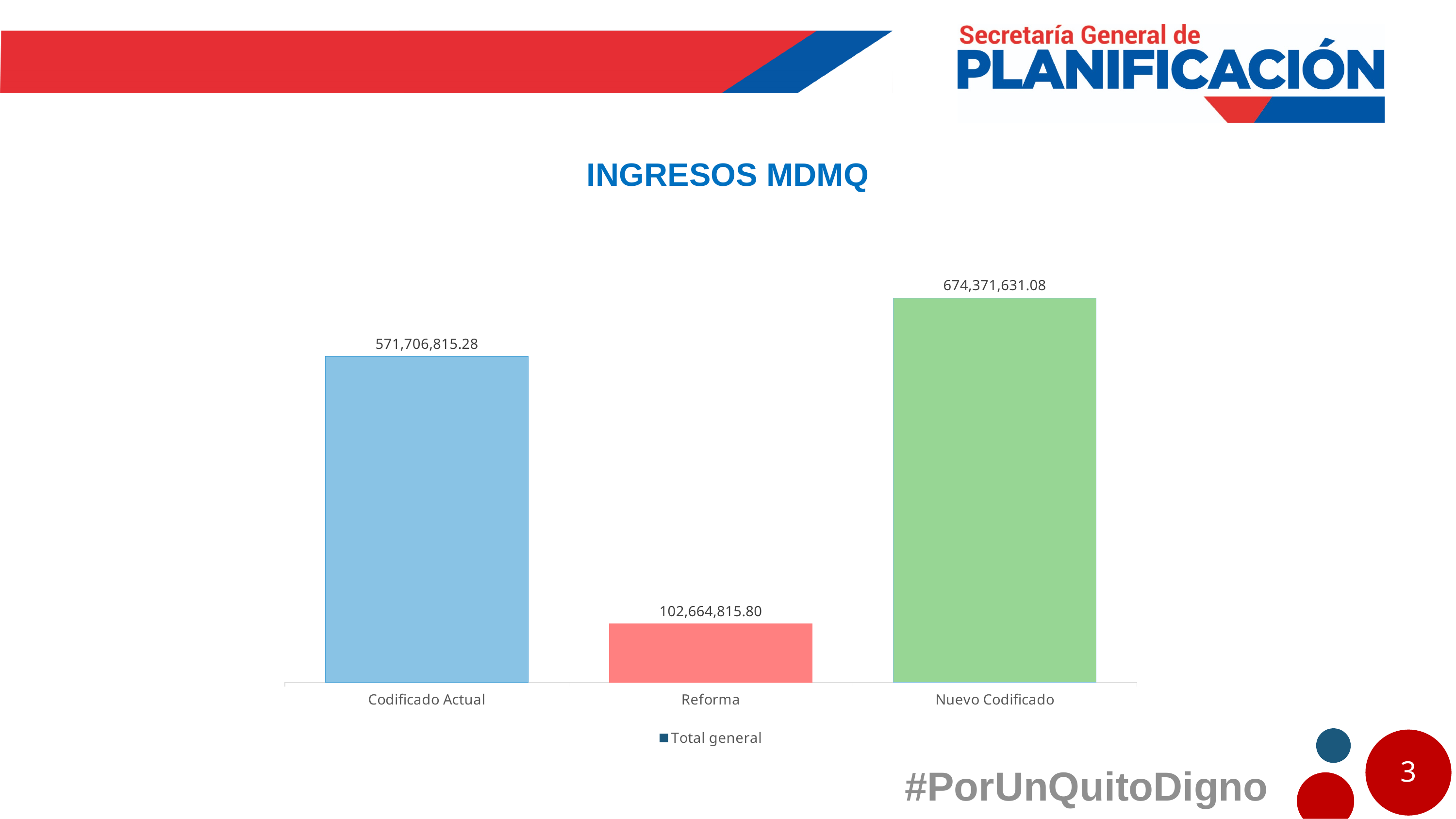
What is the difference between the values for Nuevo Codificado and Codificado Actual? 102,664,815.80 How many series does the legend list? 1 What is the difference between the values for Codificado Actual and Reforma? 469,041,999.48 What is the value for Codificado Actual? 571,706,815.28 What kind of chart is shown on the slide? Bar chart Which category has the highest value? Nuevo Codificado What is the title of the chart? INGRESOS MDMQ What is the value for Reforma? 102,664,815.80 Which category has the lowest value? Reforma What is the value for Nuevo Codificado? 674,371,631.08 Which is larger, the value for Codificado Actual or the value for Reforma? Codificado Actual How many categories are shown on the x axis? 3